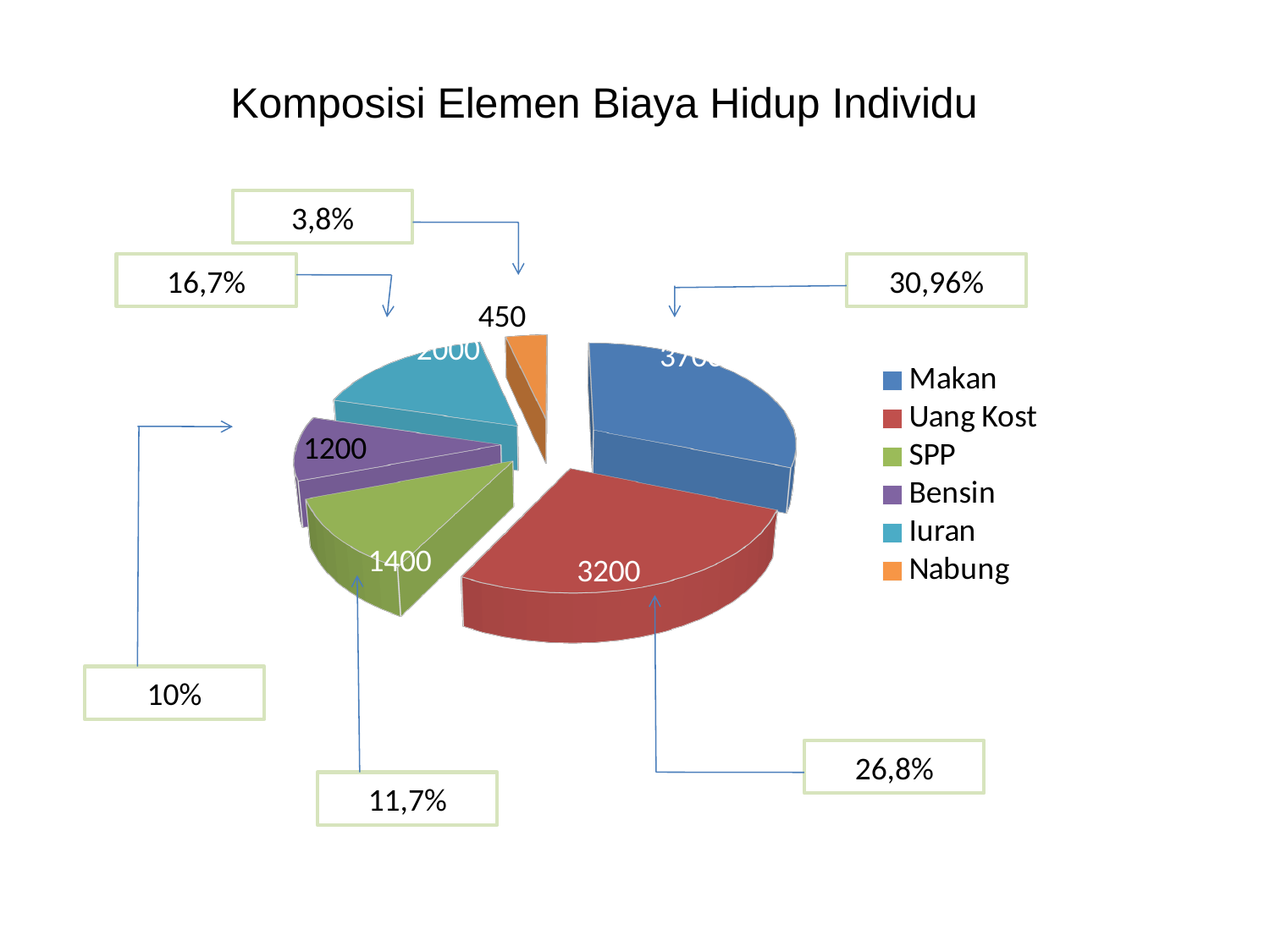
Which category has the largest slice of the pie? Makan What is the value shown for Bensin? 1200 What kind of chart is shown on the slide? pie chart What is the value shown for SPP? 1400 What is the difference between the values for Uang Kost and SPP? 1800 What is the value shown for Nabung? 450 What is the title of the chart? Komposisi Elemen Biaya Hidup Individu Which is larger, the value for Bensin or the value for SPP? SPP What is the value shown for Uang Kost? 3200 What share of the pie does Uang Kost represent, according to the callout? 26,8% How many categories does the legend of the pie chart list? 6 Which category has the smallest slice of the pie? Nabung